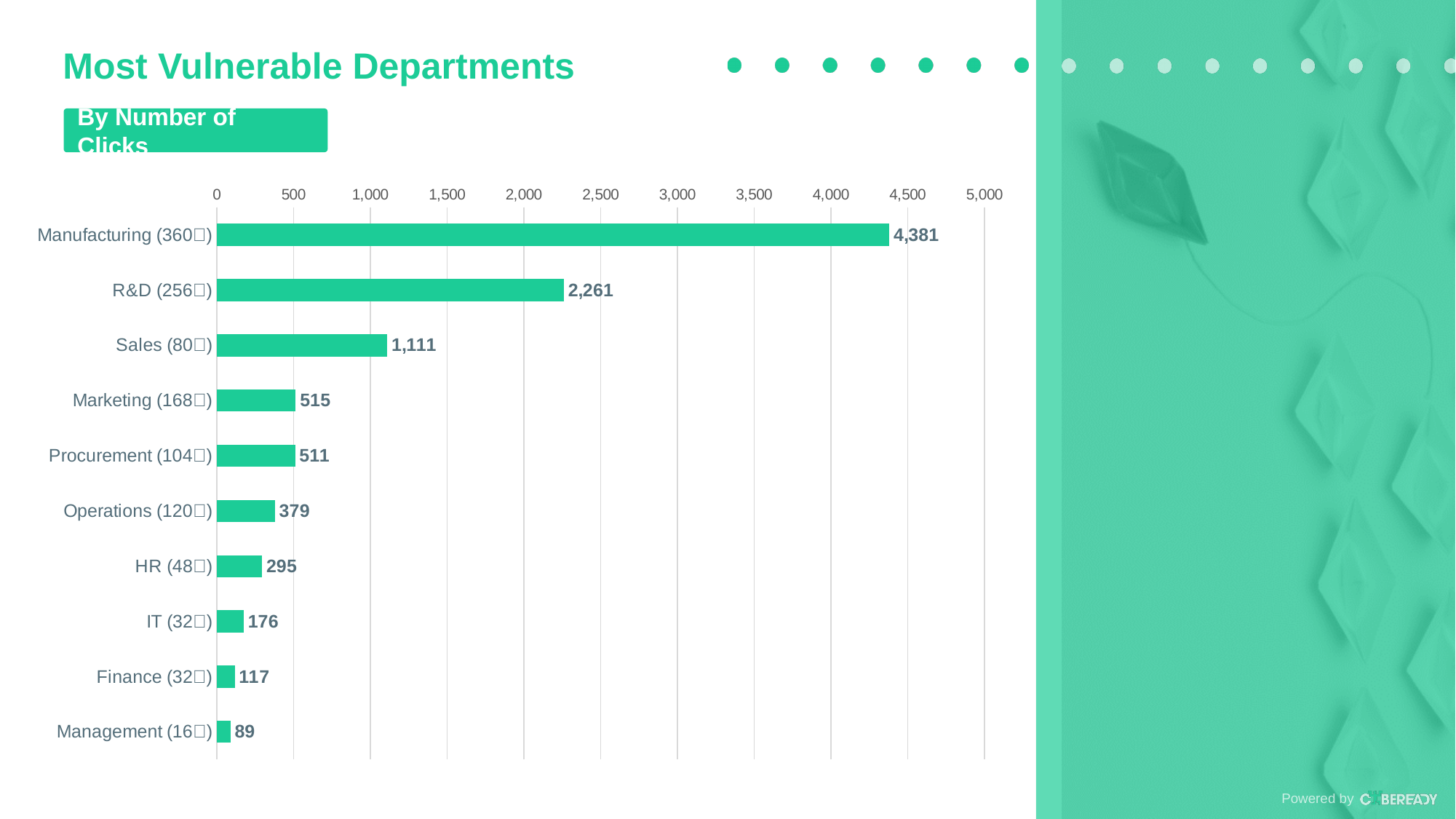
How many departments are shown in the chart? 10 Is the value for R&D greater or less than 2,000? greater What is the number of clicks for Sales? 1,111 Which department has the lowest number of clicks? Management Which department has the highest number of clicks? Manufacturing Which has more clicks, HR or IT? HR What kind of chart is shown on the slide? Bar chart What is the difference in clicks between Manufacturing and R&D? 2,120 What is the title of the chart on the slide? Most Vulnerable Departments What is the number of clicks for Operations? 379 What is the difference in clicks between Marketing and Procurement? 4 What is the number of clicks for Manufacturing? 4,381